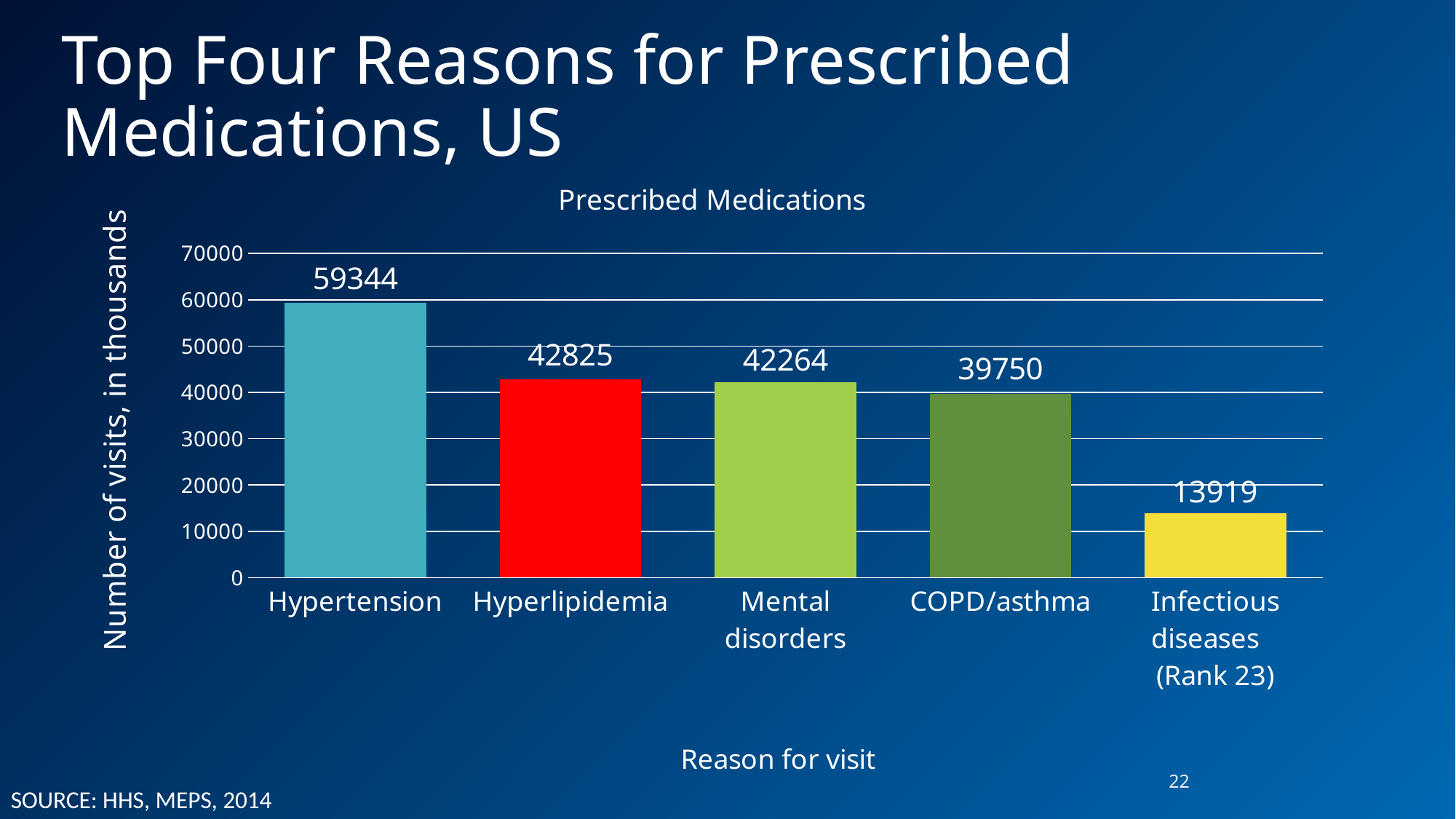
Which category has the lowest value? Infectious diseases (Rank 23) What kind of chart is shown on the slide? bar chart What is the value for Hypertension? 59344 Is the value for Mental disorders greater or less than 40000? greater What is the difference between the values for Hypertension and Hyperlipidemia? 16519 What is the value for Infectious diseases (Rank 23)? 13919 Which is larger, the value for Hyperlipidemia or the value for COPD/asthma? Hyperlipidemia What is the title of the chart? Prescribed Medications What is the difference between the values for Mental disorders and COPD/asthma? 2514 Which category has the highest value? Hypertension How many categories are shown on the x axis? 5 What is the value for COPD/asthma? 39750